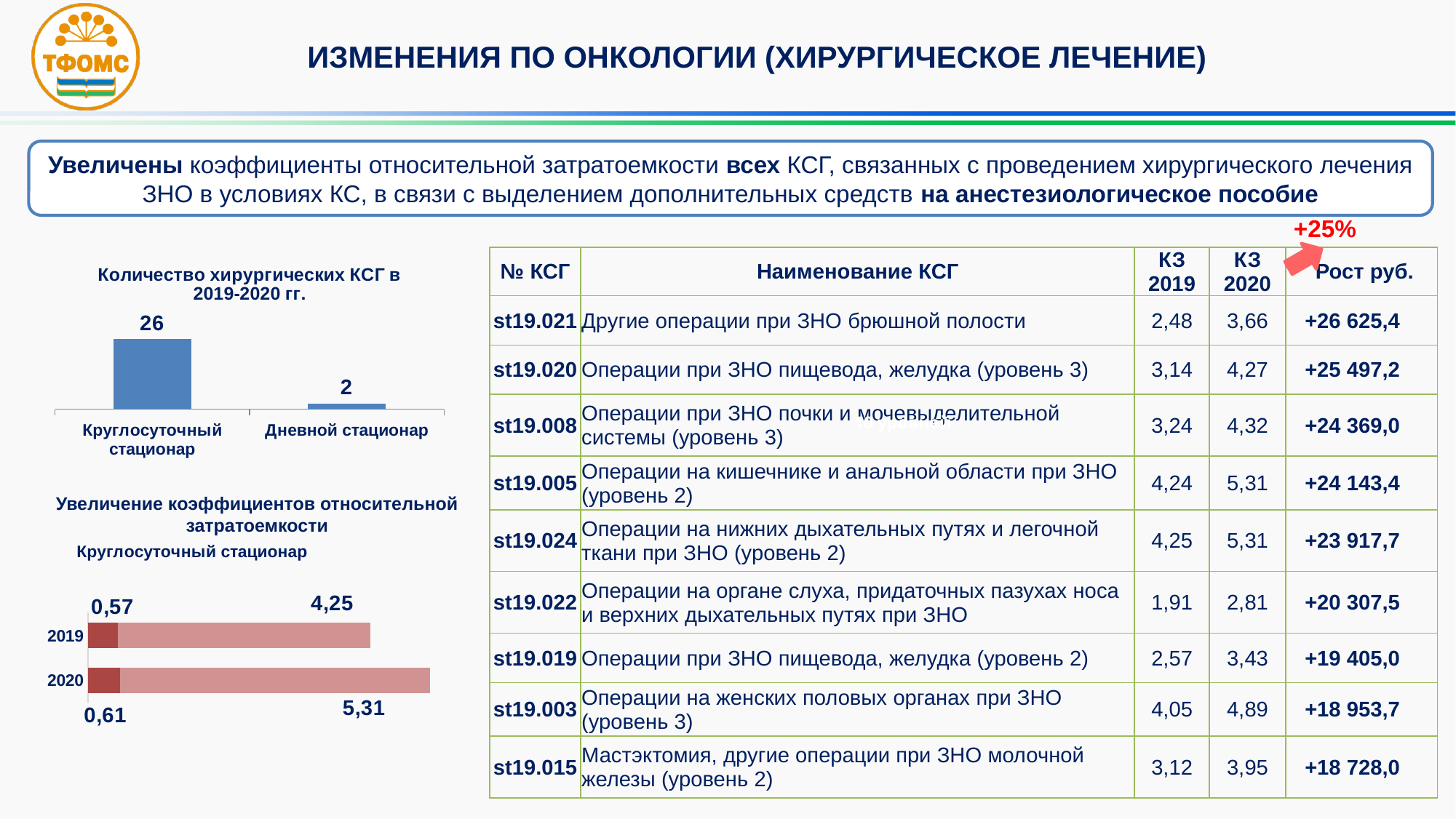
In the chart 'Количество хирургических КСГ в 2019-2020 гг.', what is the value for Дневной стационар? 2 In the chart 'Увеличение коэффициентов относительной затратоемкости', what is the larger value labelled for 2020? 5,31 In the chart 'Количество хирургических КСГ в 2019-2020 гг.', what is the value for Круглосуточный стационар? 26 In the chart 'Увеличение коэффициентов относительной затратоемкости', what is the smaller value labelled for 2020? 0,61 In the chart 'Увеличение коэффициентов относительной затратоемкости', which year has the longer bar, 2019 or 2020? 2020 In the chart 'Количество хирургических КСГ в 2019-2020 гг.', which category has the highest value? Круглосуточный стационар In the chart 'Количество хирургических КСГ в 2019-2020 гг.', which category has the lowest value? Дневной стационар In the chart 'Увеличение коэффициентов относительной затратоемкости', what is the difference between the larger values for 2020 and 2019? 1,06 In the chart 'Увеличение коэффициентов относительной затратоемкости', what is the larger value labelled for 2019? 4,25 What type of chart is 'Количество хирургических КСГ в 2019-2020 гг.'? Bar chart In the chart 'Количество хирургических КСГ в 2019-2020 гг.', how many categories are shown? 2 In the chart 'Количество хирургических КСГ в 2019-2020 гг.', what is the difference between Круглосуточный стационар and Дневной стационар? 24